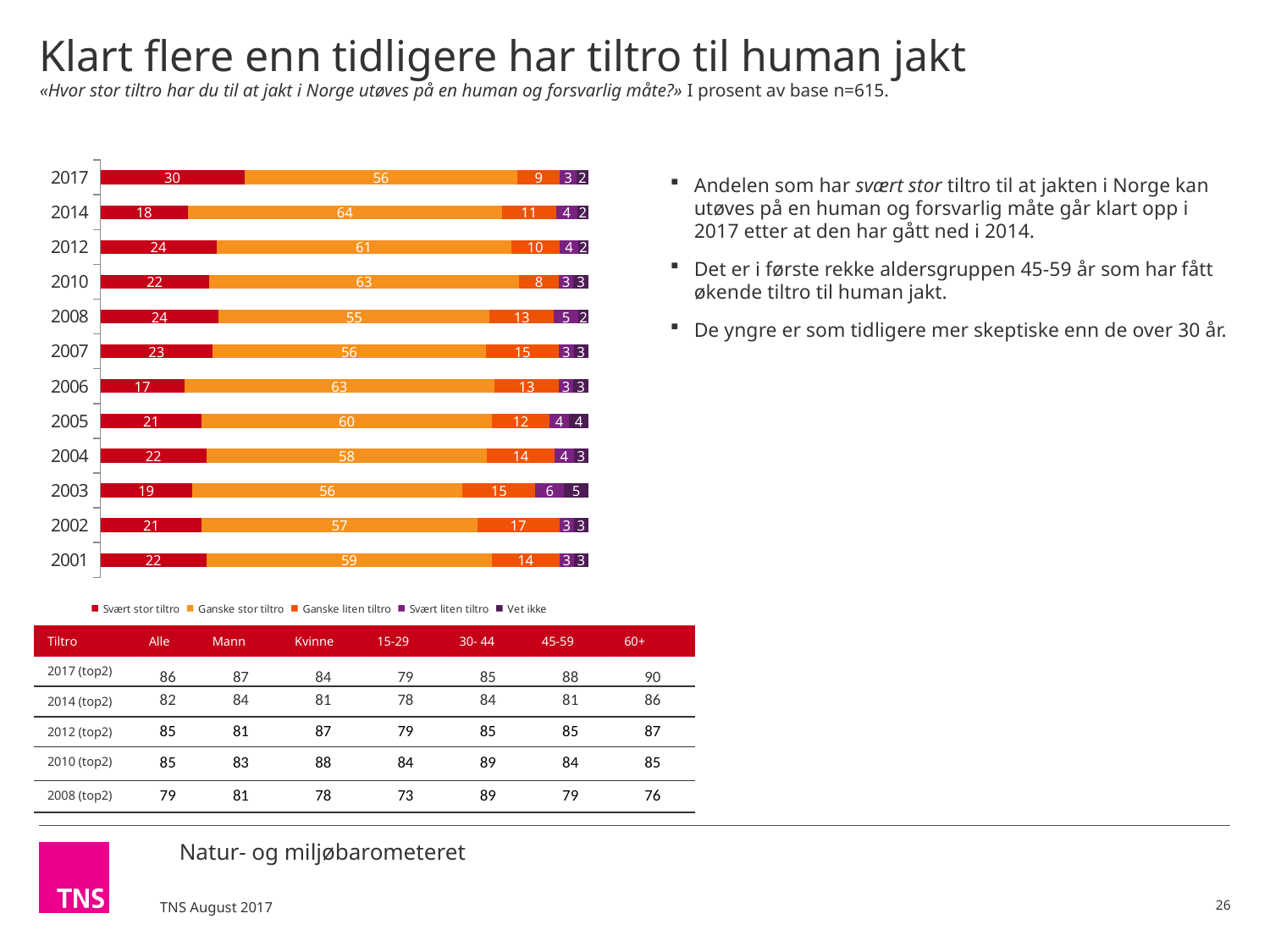
Which is larger: the "Ganske stor tiltro" value for 2010 or for 2008? 2010 What is the first entry in the chart legend? Svært stor tiltro What is the value for "Ganske stor tiltro" in 2014? 64 What is the difference between the "Svært stor tiltro" values for 2017 and 2014? 12 What is the total of the stacked bar for 2017? 100 Which year has the highest value for "Svært stor tiltro"? 2017 What is the value for "Svært stor tiltro" in 2017? 30 What is the value for "Ganske liten tiltro" in 2002? 17 What kind of chart is shown on the slide? Stacked bar chart How many series does the legend list? 5 Which year has the lowest value for "Svært stor tiltro"? 2006 How many years are shown in the chart? 12